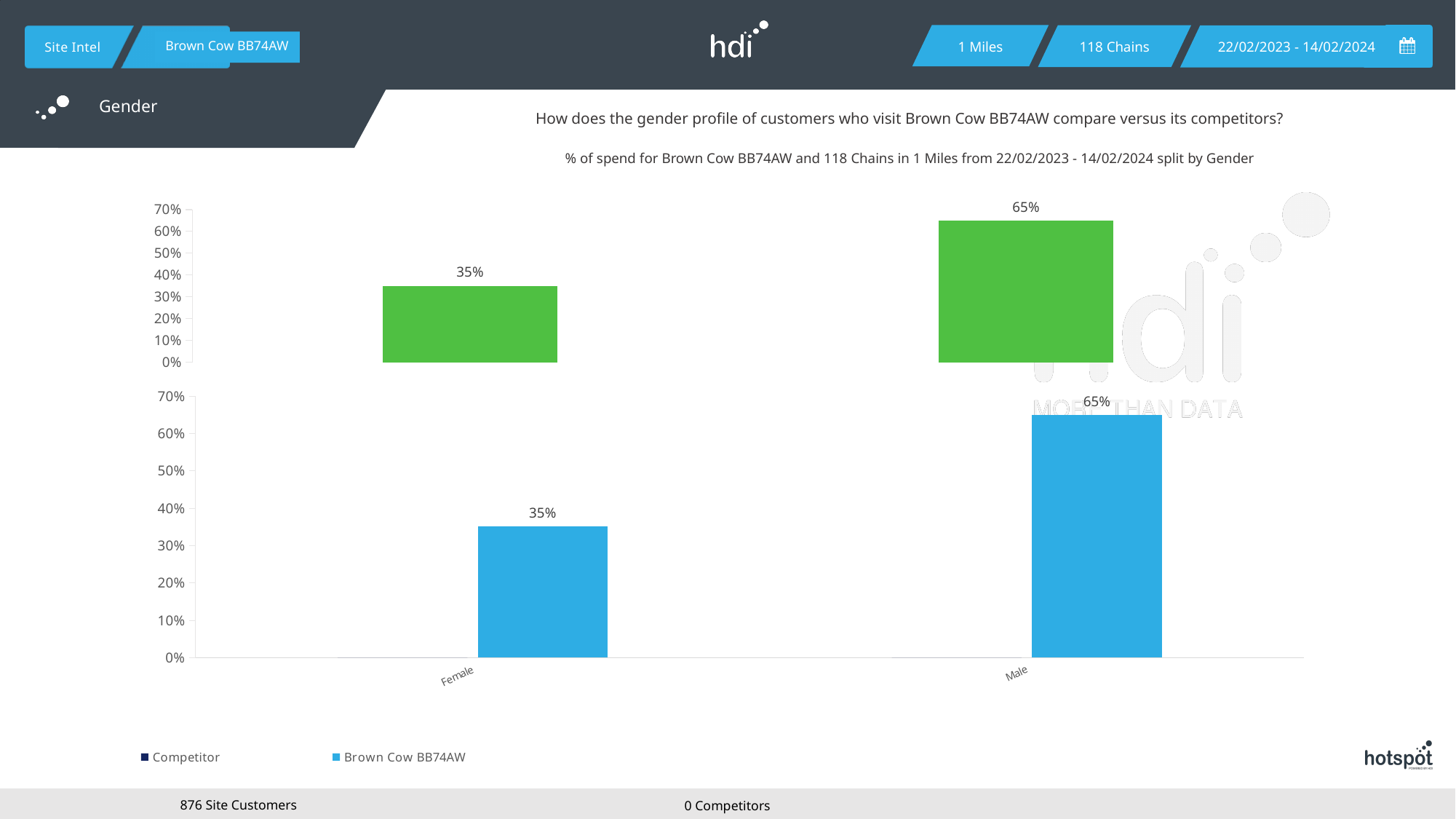
How many series does the legend at the bottom of the slide list? 2 In the lower chart, which category has the highest value? Male In the lower chart, what is the value for Male? 65% In the lower chart, how many categories are shown on the x axis? 2 In the lower chart, what is the value for Female? 35% In the lower chart, which category has the lowest value? Female In the upper chart, what value is labelled on the right green bar? 65% In the lower chart, is the value for Female greater or less than 40%? less What colour are the bars in the lower chart? blue In the lower chart, what is the difference between the Male and Female values? 30% What kind of chart is the lower chart? bar chart In the upper chart, what value is labelled on the left green bar? 35%